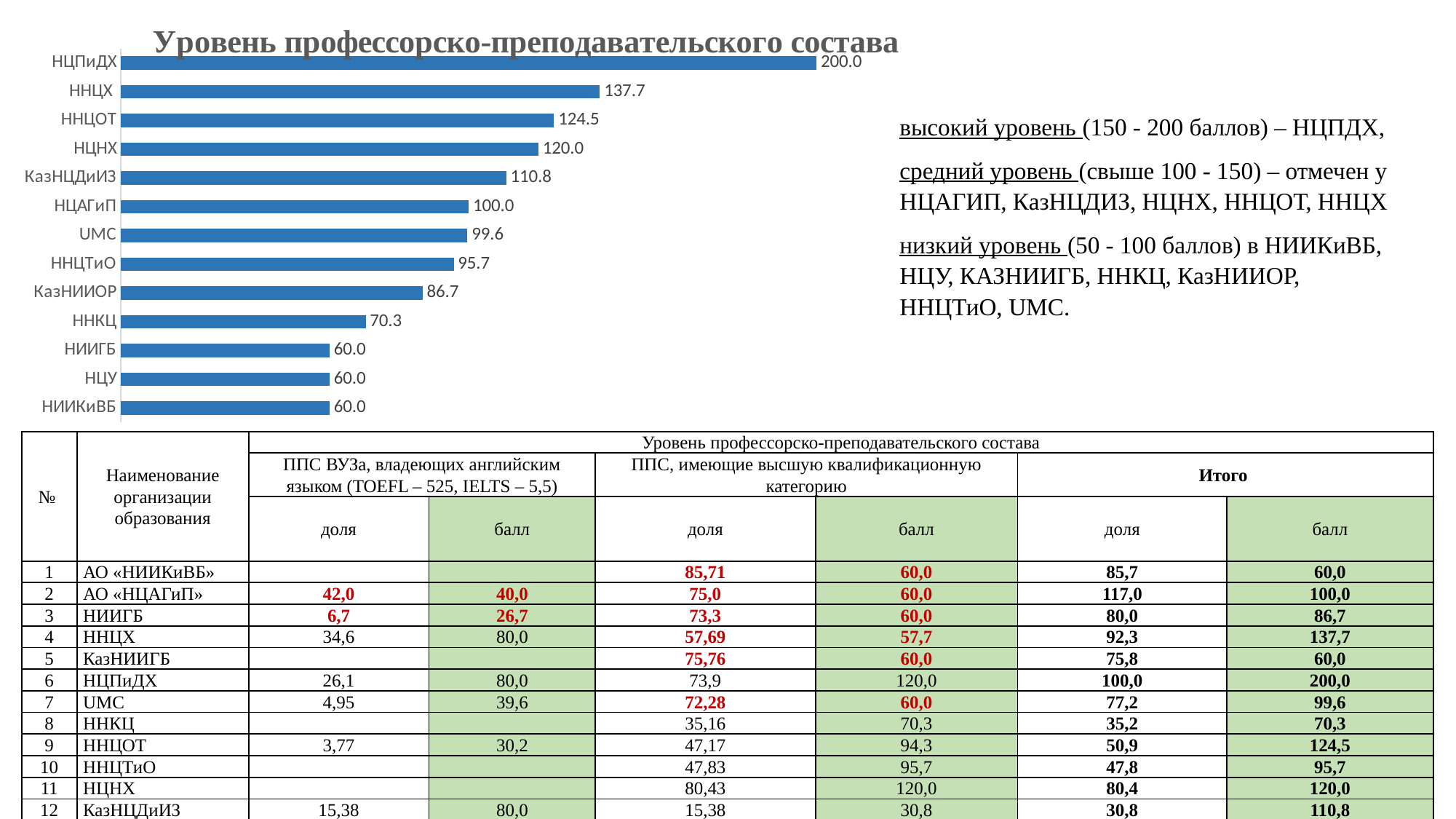
What is the value for КазНЦДиИЗ in the chart? 110.8 What type of chart is shown on the slide? bar chart What is the difference between the values for КазНИИОР and ННКЦ? 16.4 Which category has the highest value in the chart? НЦПиДХ What is the difference between the values for НЦПиДХ and ННЦХ? 62.3 How many categories are shown in the chart? 13 What is the value for ННЦХ in the chart? 137.7 What is the lowest value shown in the chart? 60.0 What is the value for ННКЦ in the chart? 70.3 Which is larger, the value for ННЦОТ or the value for НЦНХ? ННЦОТ What is the value for UMC in the chart? 99.6 What is the title of the chart? Уровень профессорско-преподавательского состава